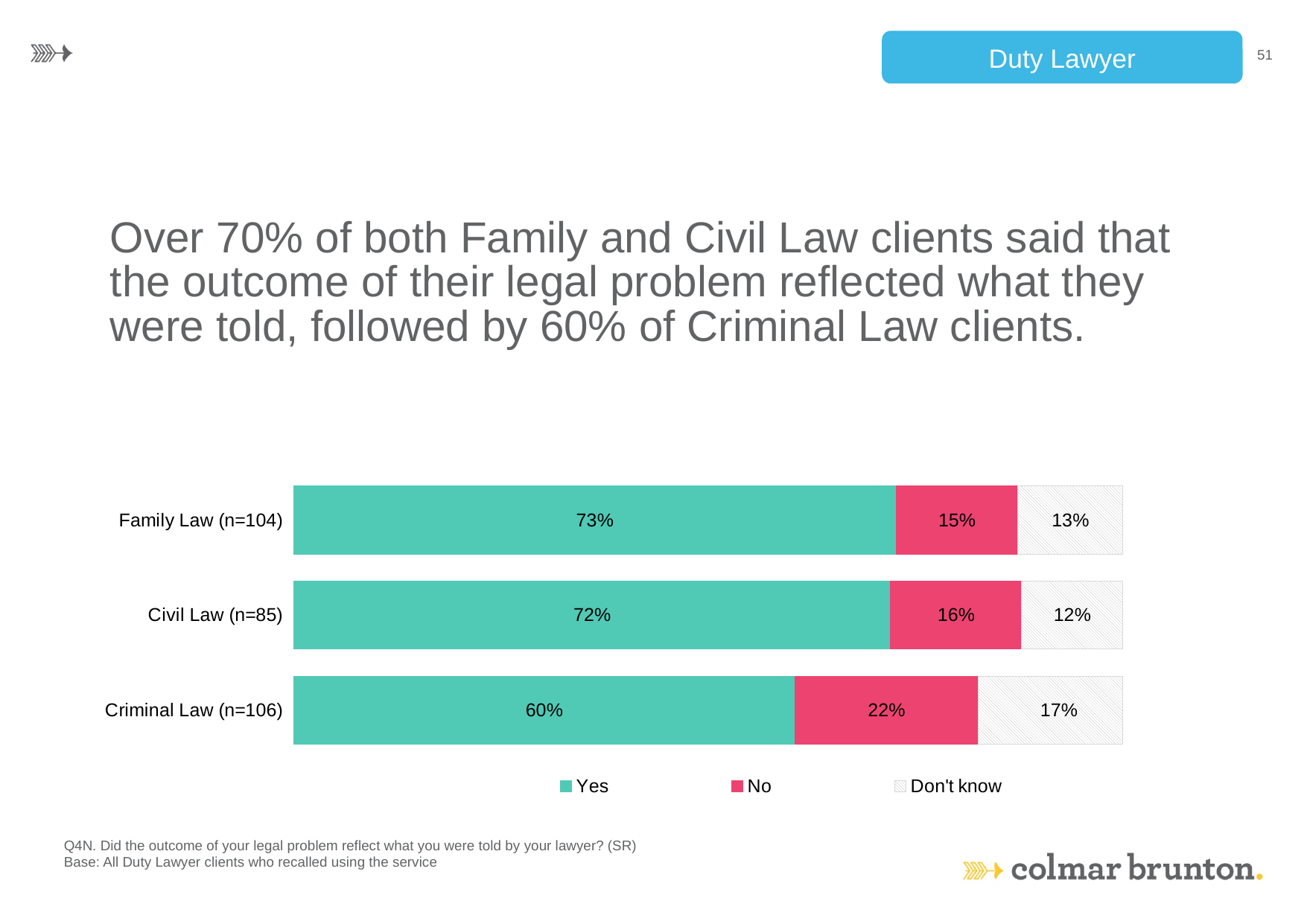
What is the total of the three segments in the Criminal Law bar? 99% What kind of chart is shown on the slide? Stacked bar chart What is the difference between the Yes percentage for Family Law and Criminal Law? 13 percentage points What percentage of Criminal Law clients answered No? 22% How many categories are shown in the chart? 3 What percentage of Civil Law clients answered Don't know? 12% Which is larger: the No percentage for Criminal Law or for Civil Law? Criminal Law What percentage of Family Law clients answered Yes? 73% Which category has the highest Yes percentage? Family Law (n=104) How many series does the legend list? 3 What are the legend entries of the chart? Yes, No, Don't know Which category has the lowest Yes percentage? Criminal Law (n=106)